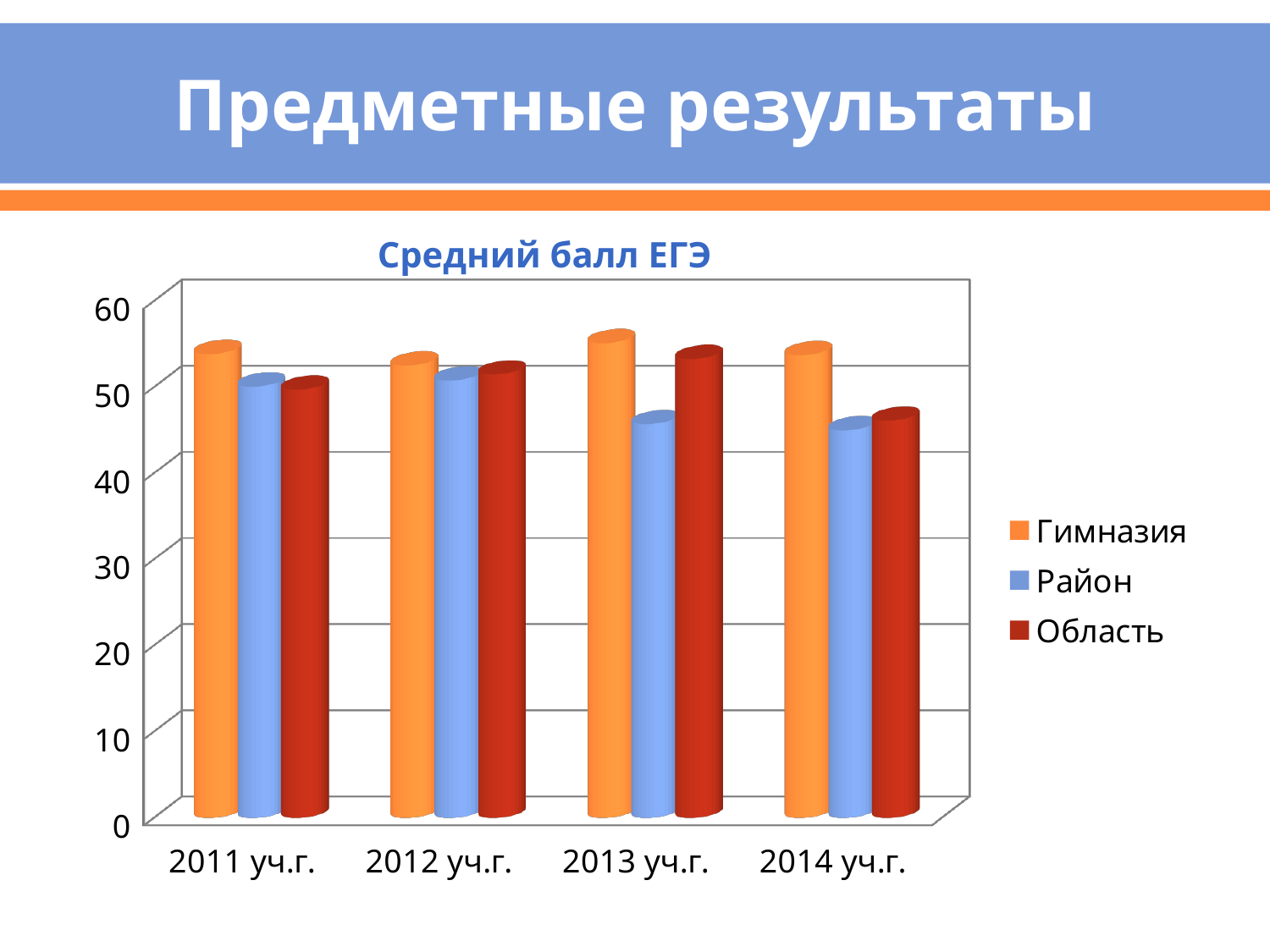
Which series has the lowest value in 2013 уч.г.? Район What is the title of the chart? Средний балл ЕГЭ Is the value for Район in 2013 уч.г. greater or less than 50? less Is the value for Область in 2014 уч.г. greater or less than 50? less Is the value for Гимназия in 2011 уч.г. greater or less than 50? greater What type of chart is shown on the slide? bar chart Which is larger for Область: the value in 2013 уч.г. or in 2014 уч.г.? 2013 уч.г. Which series has the highest value in 2013 уч.г.? Гимназия How many categories (years) are shown on the x axis? 4 How many series does the legend list? 3 Which series is shown in orange in the legend? Гимназия